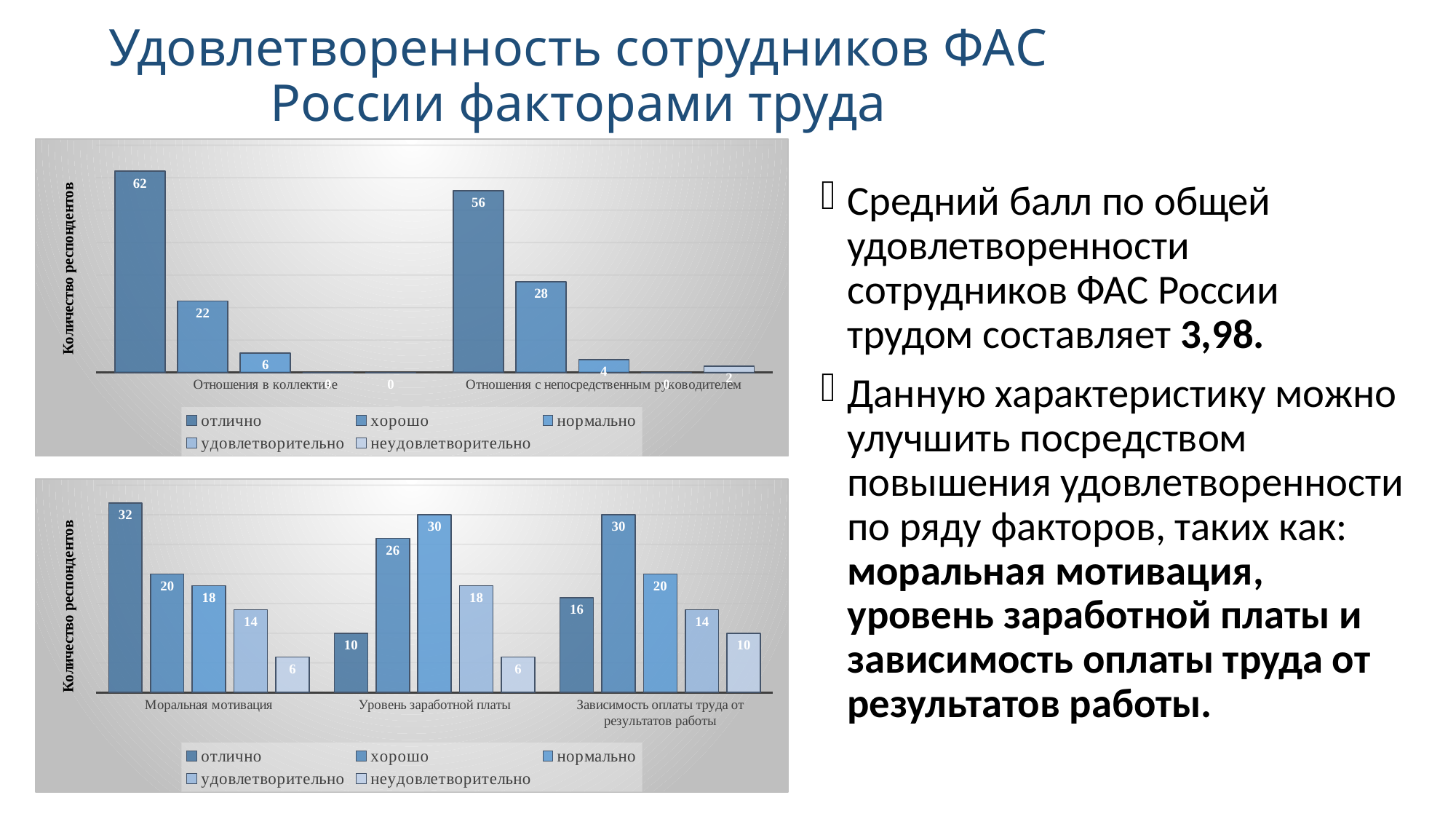
How many categories are shown on the x axis of the bottom chart? 3 In the bottom chart, what is the value for "отлично" for "Зависимость оплаты труда от результатов работы"? 16 In the bottom chart, which is larger for "Моральная мотивация": "хорошо" or "удовлетворительно"? хорошо In the top chart, what is the value for "хорошо" for "Отношения с непосредственным руководителем"? 28 In the bottom chart, what is the value for "нормально" for "Уровень заработной платы"? 30 What kind of chart is the bottom chart? Bar chart In the top chart, what is the difference between the "отлично" values for "Отношения в коллективе" and "Отношения с непосредственным руководителем"? 6 In the bottom chart, which category has the lowest "отлично" value? Уровень заработной платы In the bottom chart, what is the difference between the "неудовлетворительно" values for "Зависимость оплаты труда от результатов работы" and "Моральная мотивация"? 4 In the top chart, how many series does the legend list? 5 In the top chart, what is the value for "отлично" for "Отношения в коллективе"? 62 In the bottom chart, which category has the highest "отлично" value? Моральная мотивация